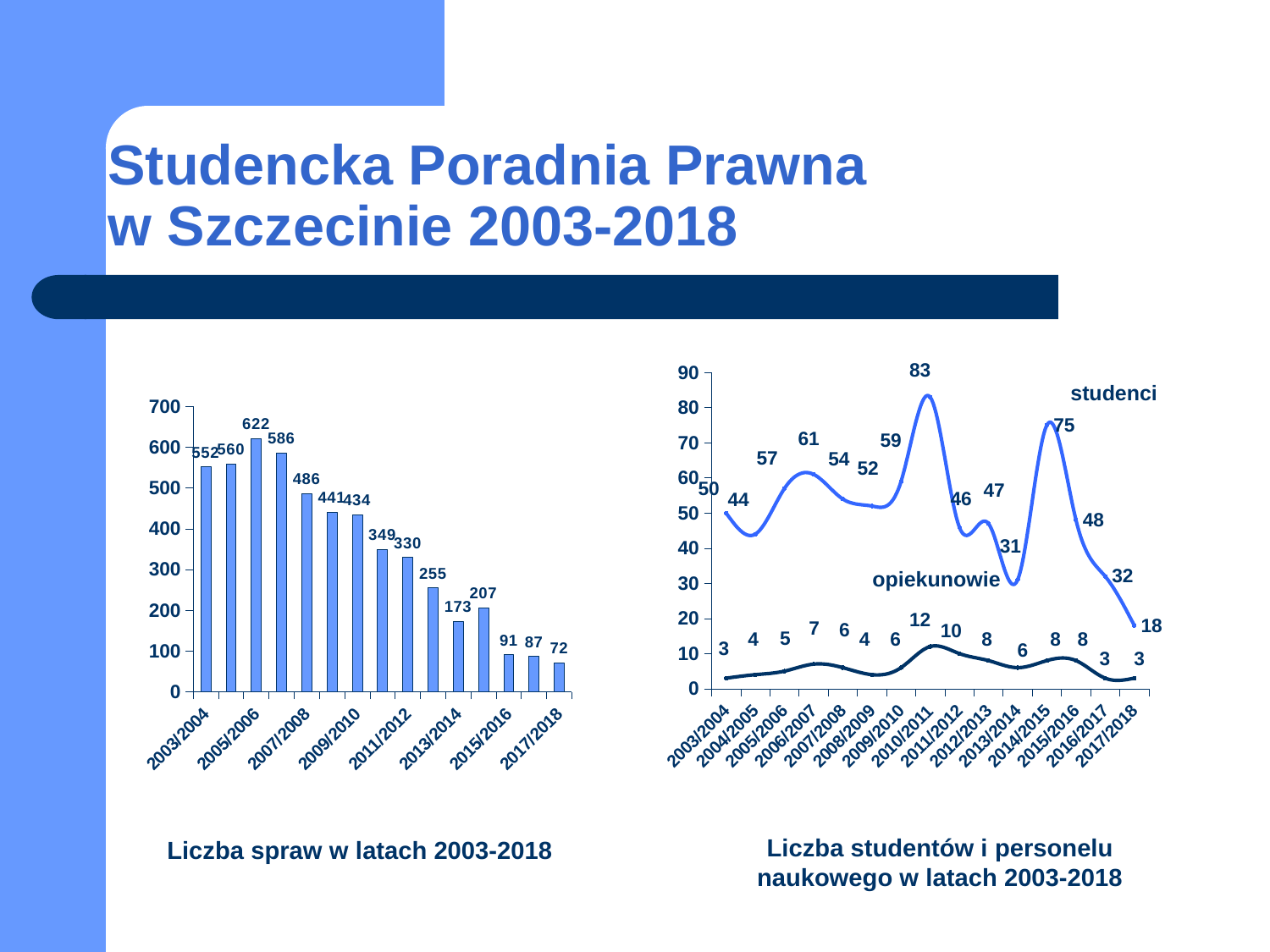
On the chart 'Liczba studentów i personelu naukowego w latach 2003-2018', in which year is the studenci value lowest? 2017/2018 On the chart 'Liczba spraw w latach 2003-2018', what is the value for 2005/2006? 622 On the chart 'Liczba studentów i personelu naukowego w latach 2003-2018', which is larger: the studenci value in 2014/2015 or in 2015/2016? 2014/2015 On the chart 'Liczba studentów i personelu naukowego w latach 2003-2018', what is the value for studenci in 2010/2011? 83 On the chart 'Liczba spraw w latach 2003-2018', what kind of chart is shown? bar chart On the chart 'Liczba studentów i personelu naukowego w latach 2003-2018', how many series are plotted? 2 On the chart 'Liczba spraw w latach 2003-2018', which year has the highest value? 2005/2006 On the chart 'Liczba spraw w latach 2003-2018', what is the value for 2017/2018? 72 On the chart 'Liczba studentów i personelu naukowego w latach 2003-2018', what is the value for opiekunowie in 2010/2011? 12 On the chart 'Liczba spraw w latach 2003-2018', what is the difference between the values for 2003/2004 and 2013/2014? 379 On the chart 'Liczba spraw w latach 2003-2018', do the values generally rise or fall from 2005/2006 to 2017/2018? fall On the chart 'Liczba spraw w latach 2003-2018', which year has the lowest value? 2017/2018